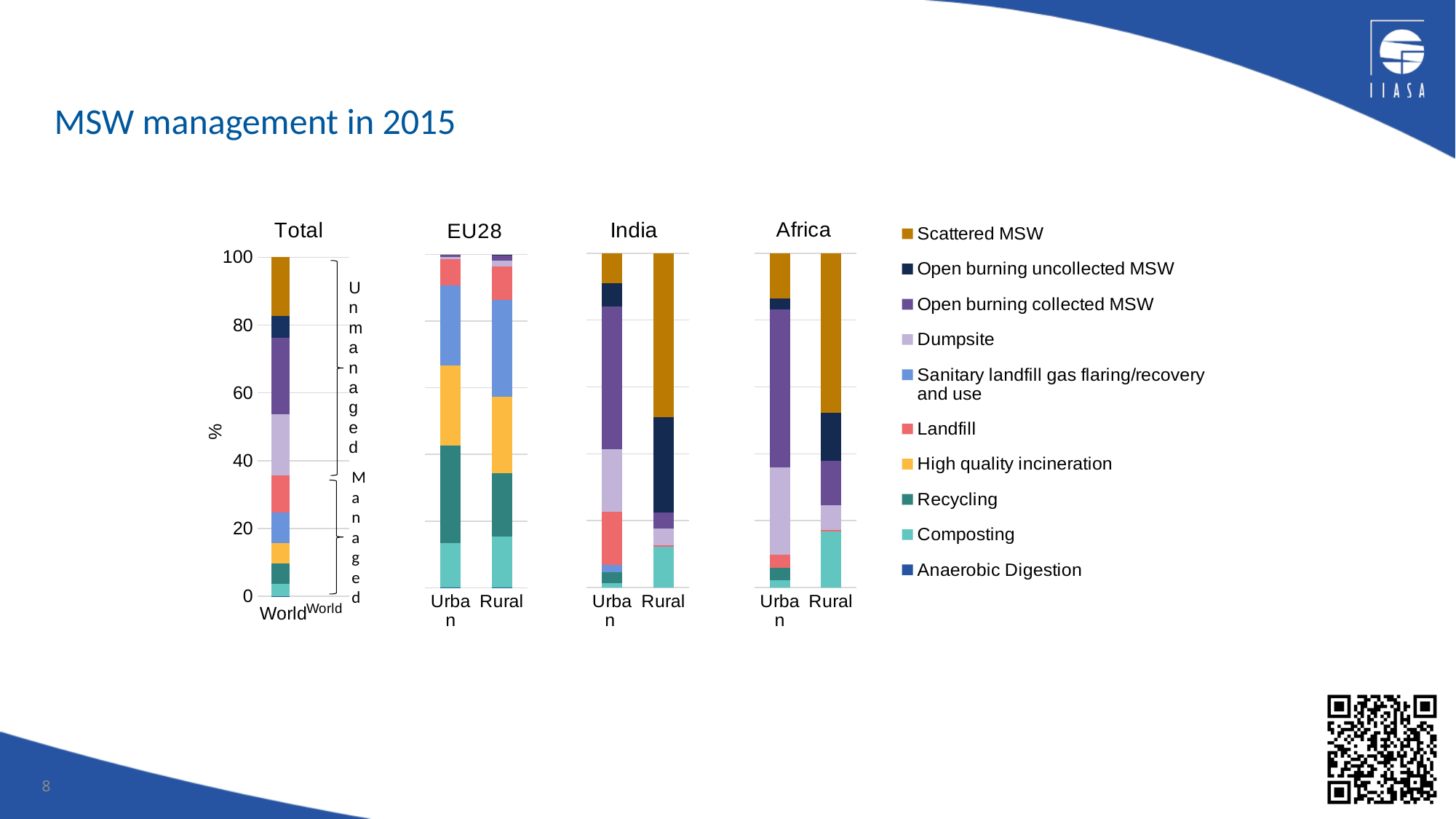
What is the label on the vertical axis of the Total chart? % In the Africa chart, which bar has the larger Composting segment, Urban or Rural? Rural How many bars are plotted in the Total chart? 1 In the EU28 chart, which bar has the larger Recycling segment, Urban or Rural? Urban How many series does the legend list? 10 In the India chart, is the Scattered MSW segment for Rural greater or less than 40? greater In the EU28 chart, is the Sanitary landfill gas flaring/recovery and use segment for Rural greater or less than 20? greater How many bars are plotted in the EU28 chart? 2 In the EU28 chart, is the Recycling segment for Urban greater or less than 20? greater In the India chart, which bar has the larger Scattered MSW segment, Urban or Rural? Rural What kind of chart is the Total chart? stacked bar chart